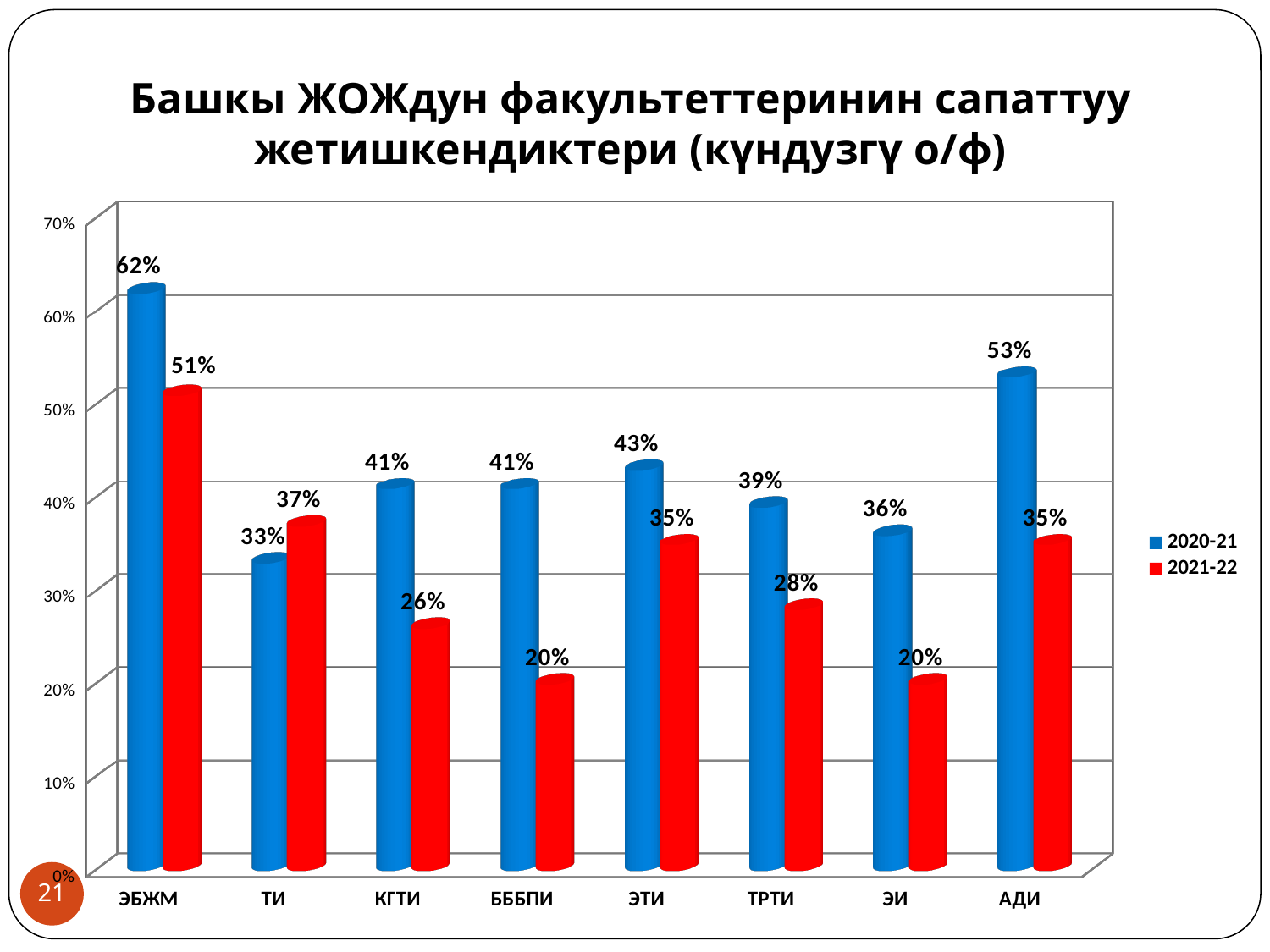
How many categories are shown on the x axis? 8 What is the value for КГТИ in the 2021-22 series? 26% What is the value for ЭБЖМ in the 2020-21 series? 62% What is the difference between the 2020-21 values for ЭБЖМ and АДИ? 9% How many series does the legend list? 2 Which category has the highest value in the 2020-21 series? ЭБЖМ Which category has the lowest value in the 2020-21 series? ТИ Which colour represents the 2021-22 series? Red What kind of chart is shown on the slide? Bar chart Which is larger for ТИ: the 2020-21 value or the 2021-22 value? 2021-22 What is the value for ТРТИ in the 2021-22 series? 28% What is the difference between the 2020-21 and 2021-22 values for БББПИ? 21%